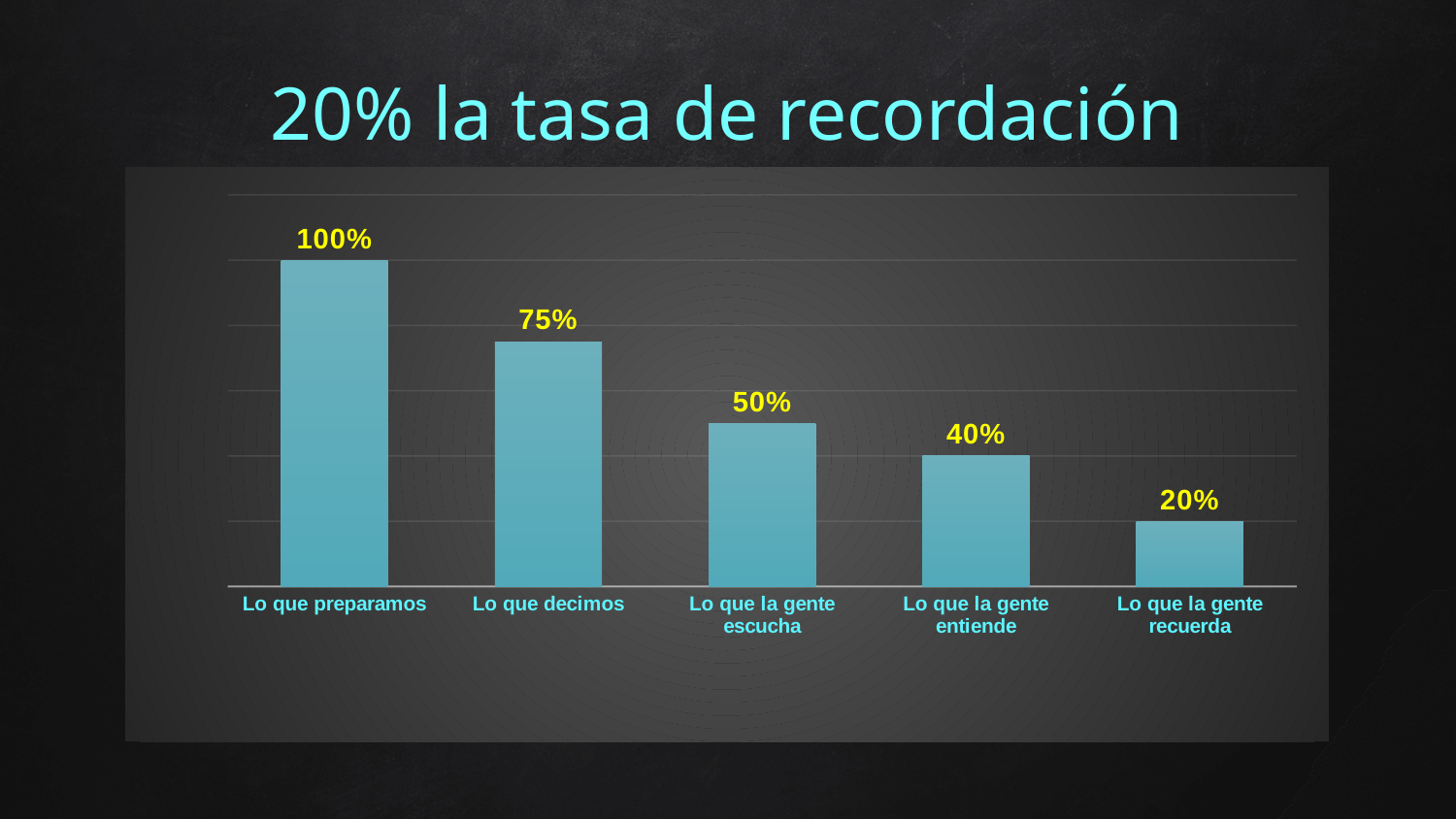
What is the difference between the values for "Lo que preparamos" and "Lo que la gente recuerda"? 80% What kind of chart is shown on the slide? Bar chart What is the value for "Lo que la gente escucha"? 50% What is the difference between the values for "Lo que decimos" and "Lo que la gente escucha"? 25% How many categories are shown in the chart? 5 What is the value for "Lo que la gente recuerda"? 20% What is the value for "Lo que decimos"? 75% What is the value for "Lo que la gente entiende"? 40% Which category has the highest value? Lo que preparamos Which is larger, the value for "Lo que la gente escucha" or "Lo que la gente entiende"? Lo que la gente escucha What is the value for "Lo que preparamos"? 100% Which category has the lowest value? Lo que la gente recuerda